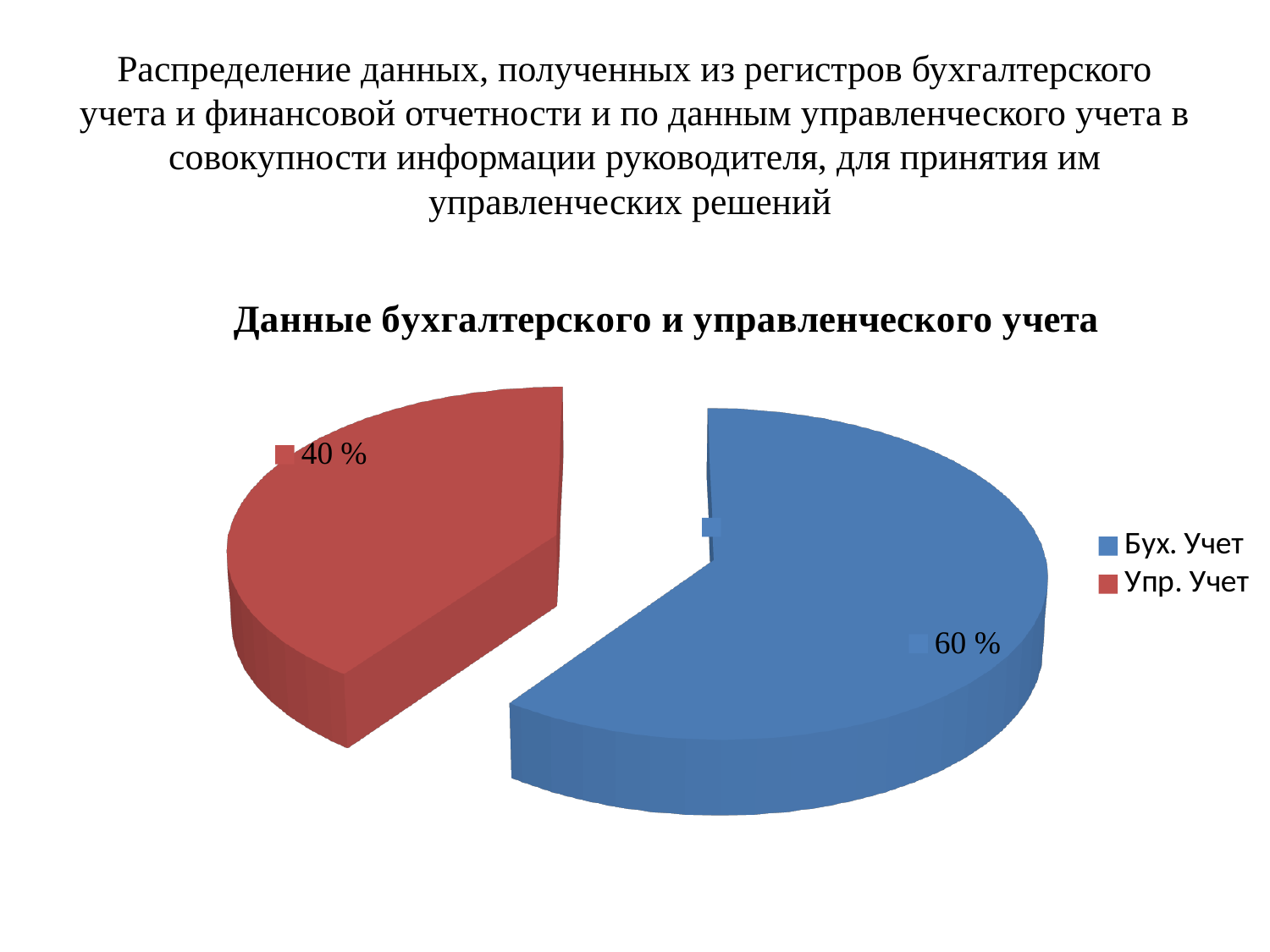
What share of the pie does Упр. Учет take? 40 % How many slices does the pie chart have? 2 What colour is the slice for Упр. Учет? red What is the title of the chart? Данные бухгалтерского и управленческого учета What kind of chart is shown on the slide? pie chart How many entries does the legend list? 2 Which category has the smallest slice? Упр. Учет What is the value for Упр. Учет? 40 % Which category has the largest slice? Бух. Учет What is the difference between the values for Бух. Учет and Упр. Учет? 20 % Which is larger, the value for Бух. Учет or the value for Упр. Учет? Бух. Учет What is the value for Бух. Учет? 60 %